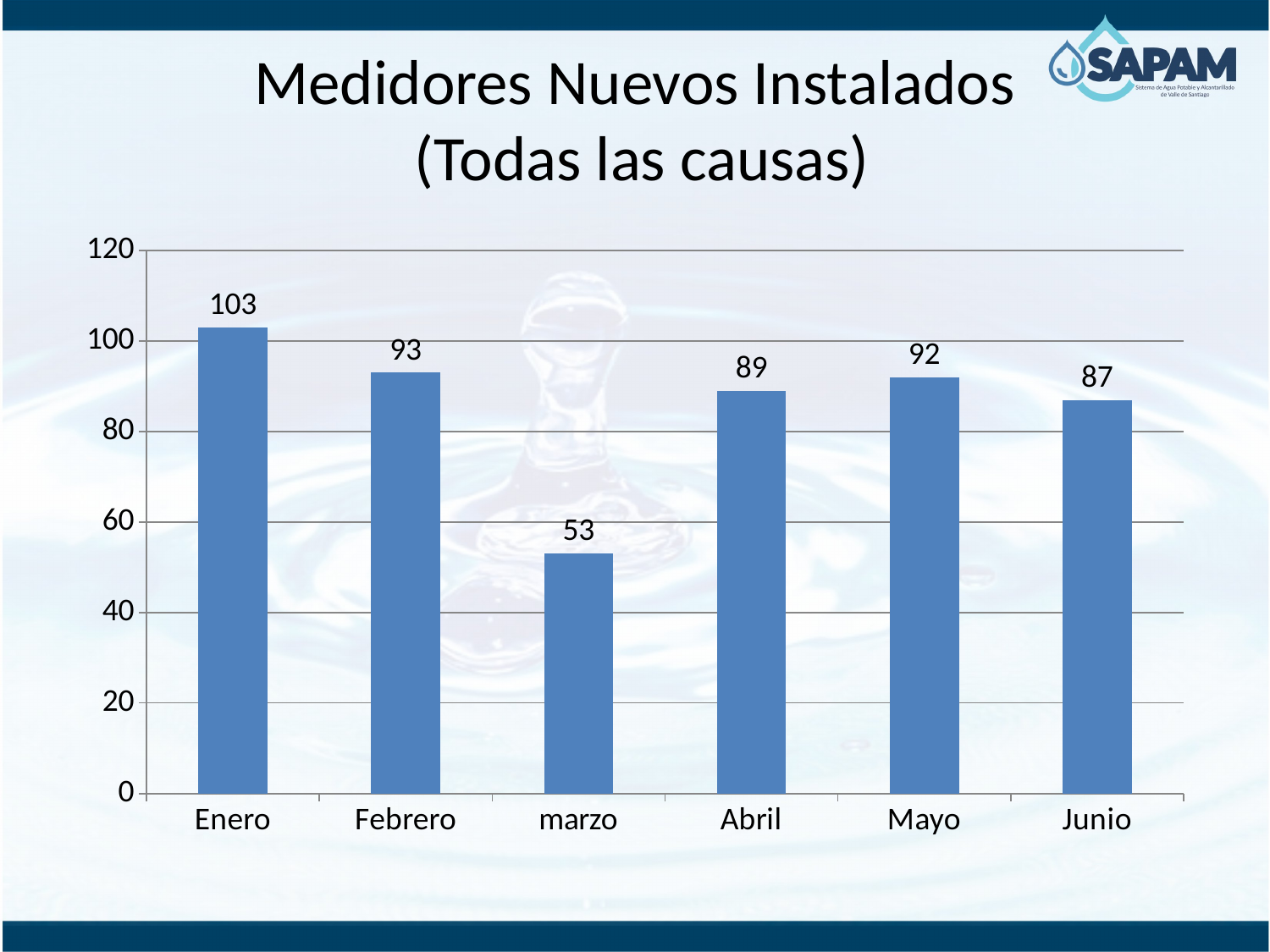
What kind of chart is shown on the slide? bar chart Which is larger, the value for Abril or the value for Junio? Abril How many months are shown on the x axis? 6 What is the value for marzo? 53 Which month has the lowest value? marzo What is the value for Junio? 87 Which month has the highest value? Enero What is the title of the chart on the slide? Medidores Nuevos Instalados (Todas las causas) What is the difference between the values for Enero and marzo? 50 Is the value for Mayo greater or less than 80? greater What is the difference between the values for Febrero and Mayo? 1 What is the value for Enero? 103